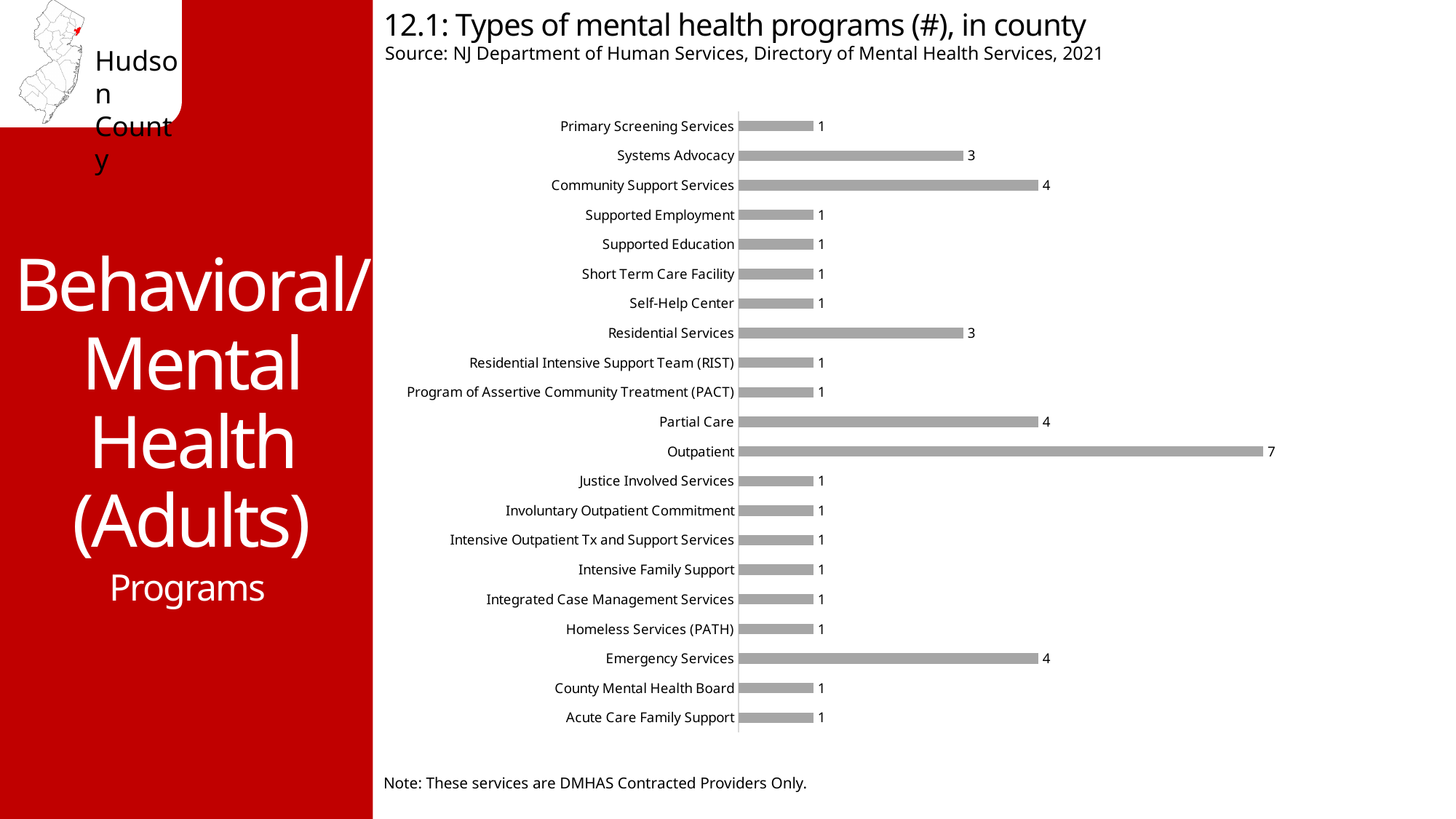
Which is larger, the value for Residential Services or the value for Self-Help Center? Residential Services What is the difference between the values for Outpatient and Partial Care? 3 What is the value for Community Support Services? 4 What is the value for Systems Advocacy? 3 What is the value for Homeless Services (PATH)? 1 How many types of mental health programs are shown in the chart? 21 Which type of mental health program has the highest number? Outpatient Which is larger, the value for Partial Care or the value for Systems Advocacy? Partial Care What kind of chart is shown on the slide? Bar chart What is the source cited for the chart? NJ Department of Human Services, Directory of Mental Health Services, 2021 What is the value for Outpatient? 7 What is the difference between the values for Emergency Services and Residential Services? 1